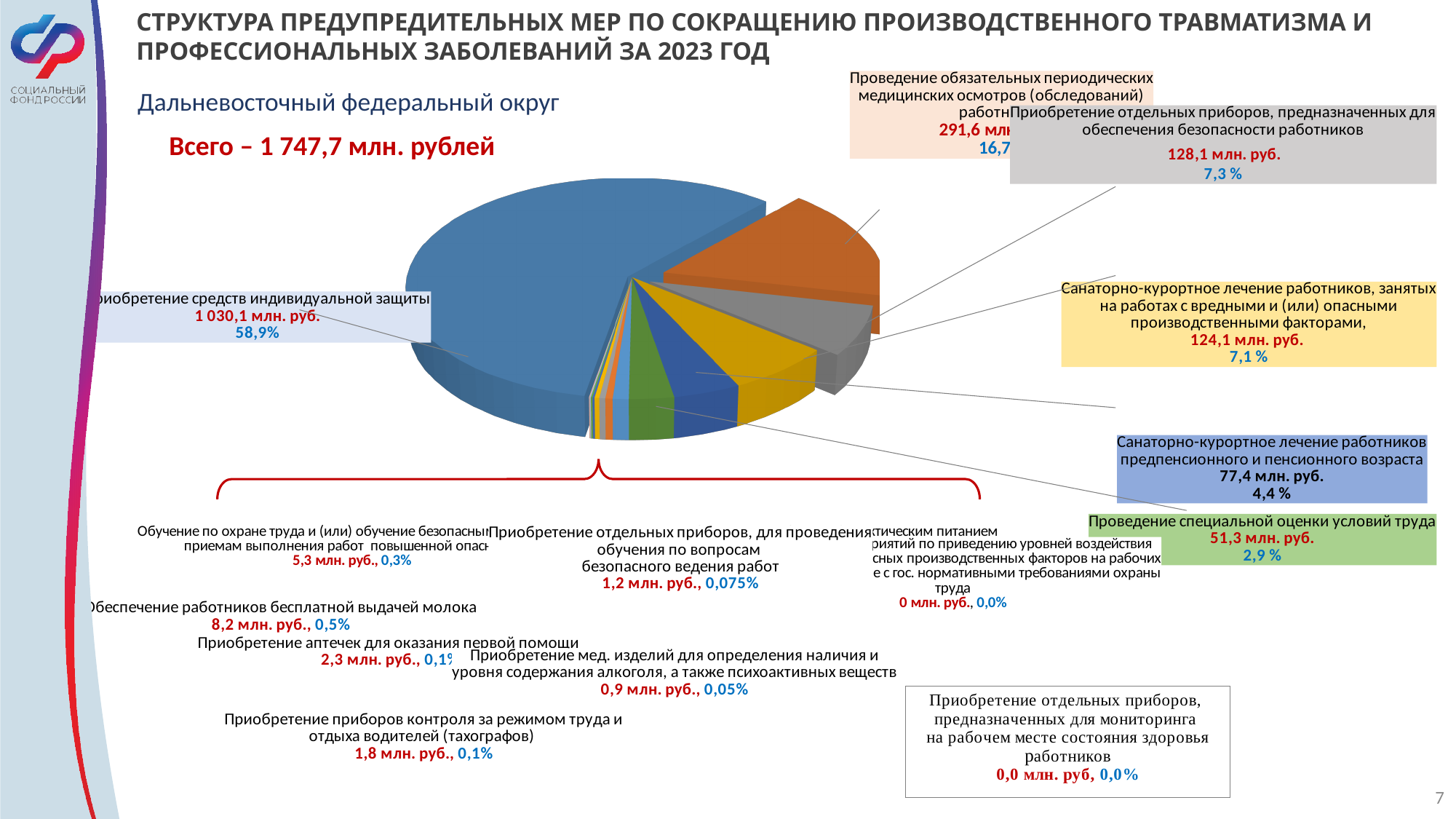
Which category has the largest slice of the pie? Приобретение средств индивидуальной защиты What percentage is shown for 'Санаторно-курортное лечение работников предпенсионного и пенсионного возраста'? 4,4 % What amount is shown for 'Приобретение приборов контроля за режимом труда и отдыха водителей (тахографов)'? 1,8 млн. руб. What amount is shown for 'Проведение специальной оценки условий труда'? 51,3 млн. руб. What amount is shown for 'Приобретение средств индивидуальной защиты'? 1 030,1 млн. руб. What is the total amount of preventive measures shown on the slide (Всего)? 1 747,7 млн. рублей What share of the pie does 'Приобретение средств индивидуальной защиты' account for? 58,9% Which federal district does the chart on the slide refer to? Дальневосточный федеральный округ What percentage is shown for 'Приобретение мед. изделий для определения наличия и уровня содержания алкоголя, а также психоактивных веществ'? 0,05% What is the difference in amount between 'Приобретение отдельных приборов, предназначенных для обеспечения безопасности работников' (128,1 млн. руб.) and 'Санаторно-курортное лечение работников, занятых на работах с вредными и (или) опасными производственными факторами' (124,1 млн. руб.)? 4,0 млн. руб. What kind of chart is shown on the slide? Pie chart Which is larger: the amount for 'Обеспечение работников бесплатной выдачей молока' or for 'Обучение по охране труда'? Обеспечение работников бесплатной выдачей молока